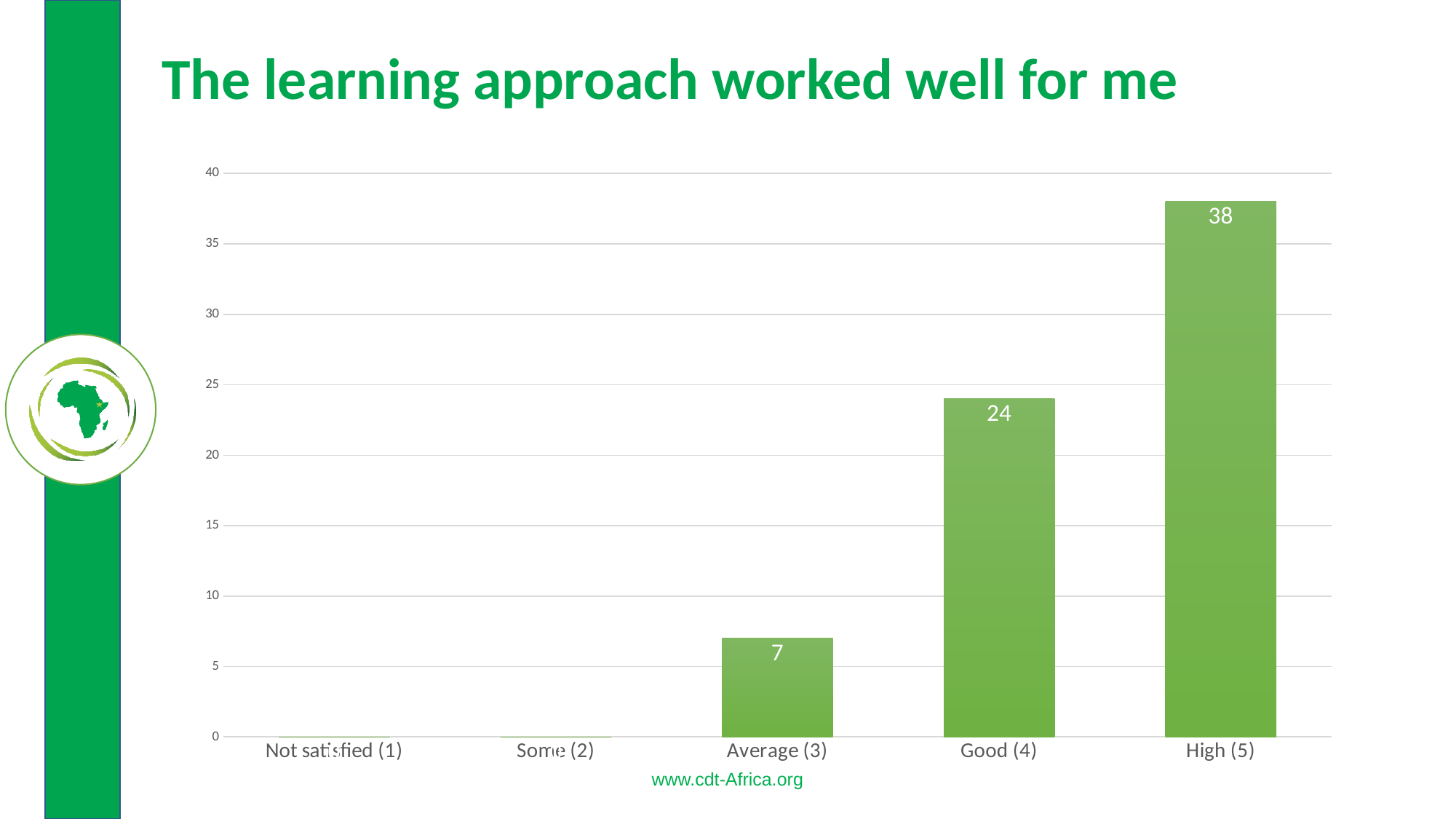
What is the difference between the values for High (5) and Good (4)? 14 Is the value for Some (2) greater or less than 5? less What is the title of the chart? The learning approach worked well for me How many categories are shown on the x axis? 5 What is the value for Good (4)? 24 What is the value for High (5)? 38 Which is larger, the value for Average (3) or the value for Good (4)? Good (4) What is the value for Average (3)? 7 What kind of chart is shown on the slide? bar chart Is the value for High (5) greater or less than 35? greater What is the difference between the values for Good (4) and Average (3)? 17 Which category has the highest value? High (5)